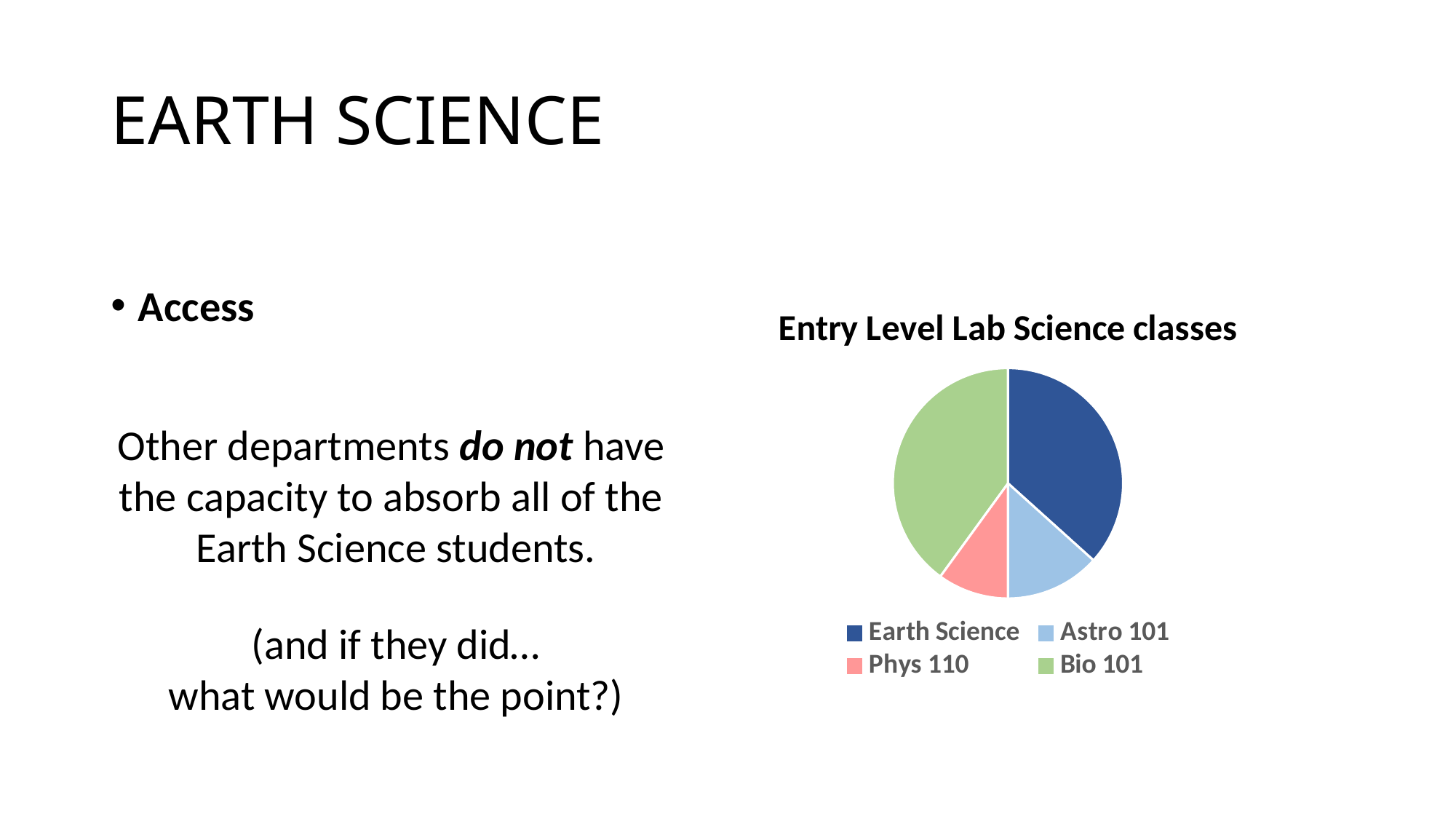
Which slice is larger, Bio 101 or Astro 101? Bio 101 Which category has the largest slice of the pie? Bio 101 Which category is shown in green in the pie chart? Bio 101 What is the title of the chart? Entry Level Lab Science classes Which slice is larger, Earth Science or Phys 110? Earth Science Which slice is larger, Earth Science or Astro 101? Earth Science What kind of chart is shown on the slide? pie chart How many categories (slices) does the pie chart have? 4